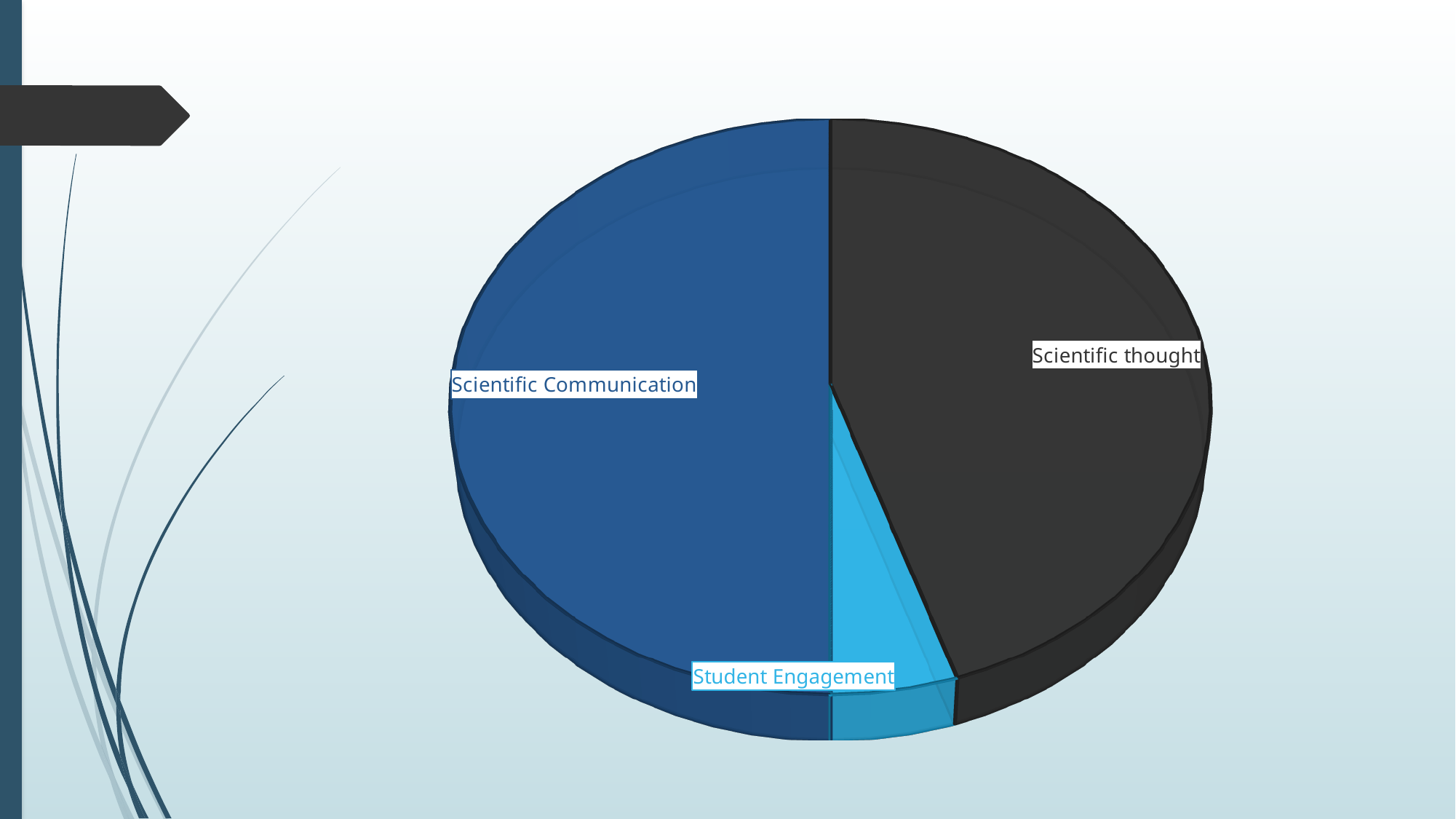
Which slice is larger, Scientific Communication or Scientific thought? Scientific Communication Does the Scientific Communication slice take up more or less than a quarter of the pie? more Which slice is larger, Scientific thought or Student Engagement? Scientific thought Does the Student Engagement slice take up more or less than a quarter of the pie? less What colour is the Scientific thought slice? Dark grey Which slice is larger, Scientific Communication or Student Engagement? Scientific Communication Which slice of the pie chart is the smallest? Student Engagement What colour is the Student Engagement slice? Light blue Which slice of the pie chart is the largest? Scientific Communication How many slices does the pie chart have? 3 What kind of chart is shown on the slide? Pie chart